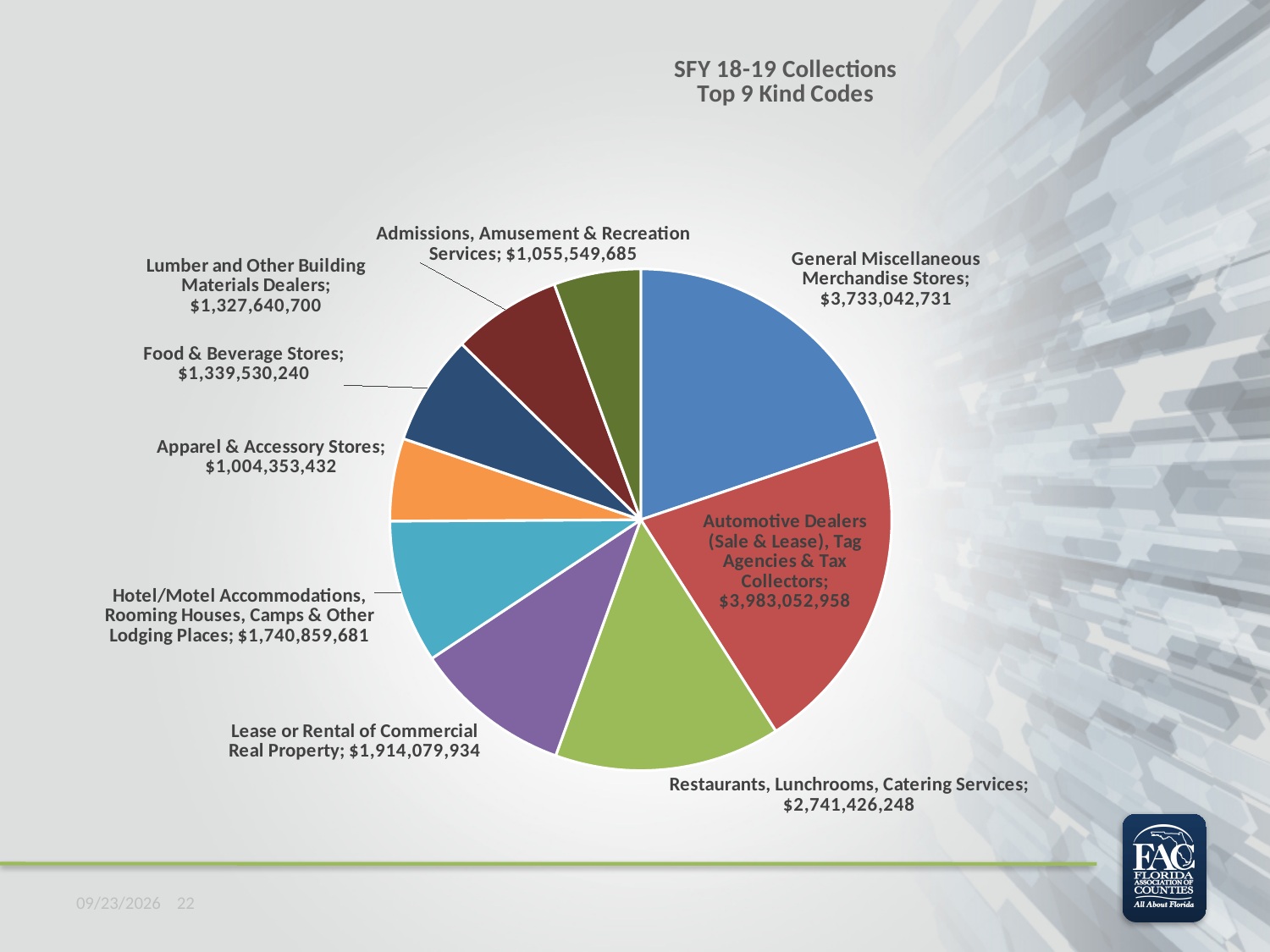
What is the difference between the collections for Automotive Dealers (Sale & Lease), Tag Agencies & Tax Collectors and General Miscellaneous Merchandise Stores? $250,010,227 What is the title of the pie chart? SFY 18-19 Collections Top 9 Kind Codes What kind of chart is shown on the slide? Pie chart Which kind code has the largest collections? Automotive Dealers (Sale & Lease), Tag Agencies & Tax Collectors What is the value for Restaurants, Lunchrooms, Catering Services? $2,741,426,248 Which is larger: Lease or Rental of Commercial Real Property or Hotel/Motel Accommodations, Rooming Houses, Camps & Other Lodging Places? Lease or Rental of Commercial Real Property What is the value for General Miscellaneous Merchandise Stores? $3,733,042,731 What is the difference between the collections for Food & Beverage Stores and Lumber and Other Building Materials Dealers? $11,889,540 How many slices does the pie chart have? 9 What is the value for Hotel/Motel Accommodations, Rooming Houses, Camps & Other Lodging Places? $1,740,859,681 Which kind code has the smallest collections? Apparel & Accessory Stores What is the value for Admissions, Amusement & Recreation Services? $1,055,549,685